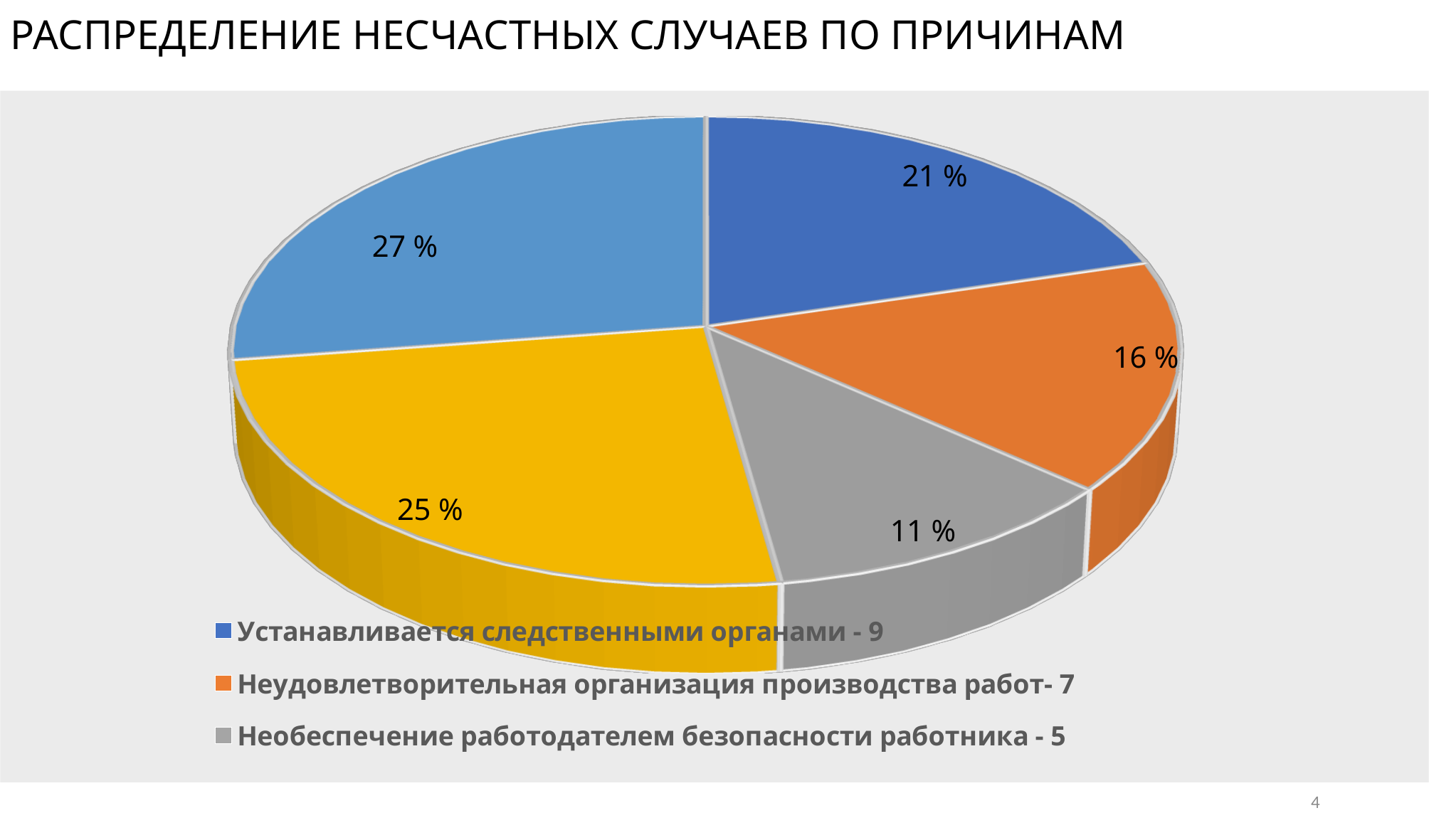
How many entries does the legend list? 3 What is the largest percentage shown on the pie chart? 27 % Which is larger: the share for 'Неудовлетворительная организация производства работ' or for 'Необеспечение работодателем безопасности работника'? Неудовлетворительная организация производства работ What percentage is shown for the slice 'Необеспечение работодателем безопасности работника'? 11 % What number is given in the legend for 'Устанавливается следственными органами'? 9 What percentage is shown for the slice 'Устанавливается следственными органами'? 21 % Which legend category has the smallest share of the pie? Необеспечение работодателем безопасности работника What kind of chart is shown on the slide? pie chart What is the difference in percentage points between 'Устанавливается следственными органами' and 'Неудовлетворительная организация производства работ'? 5 How many slices does the pie chart have? 5 What percentage is shown for the slice 'Неудовлетворительная организация производства работ'? 16 % What is the title of the slide? РАСПРЕДЕЛЕНИЕ НЕСЧАСТНЫХ СЛУЧАЕВ ПО ПРИЧИНАМ